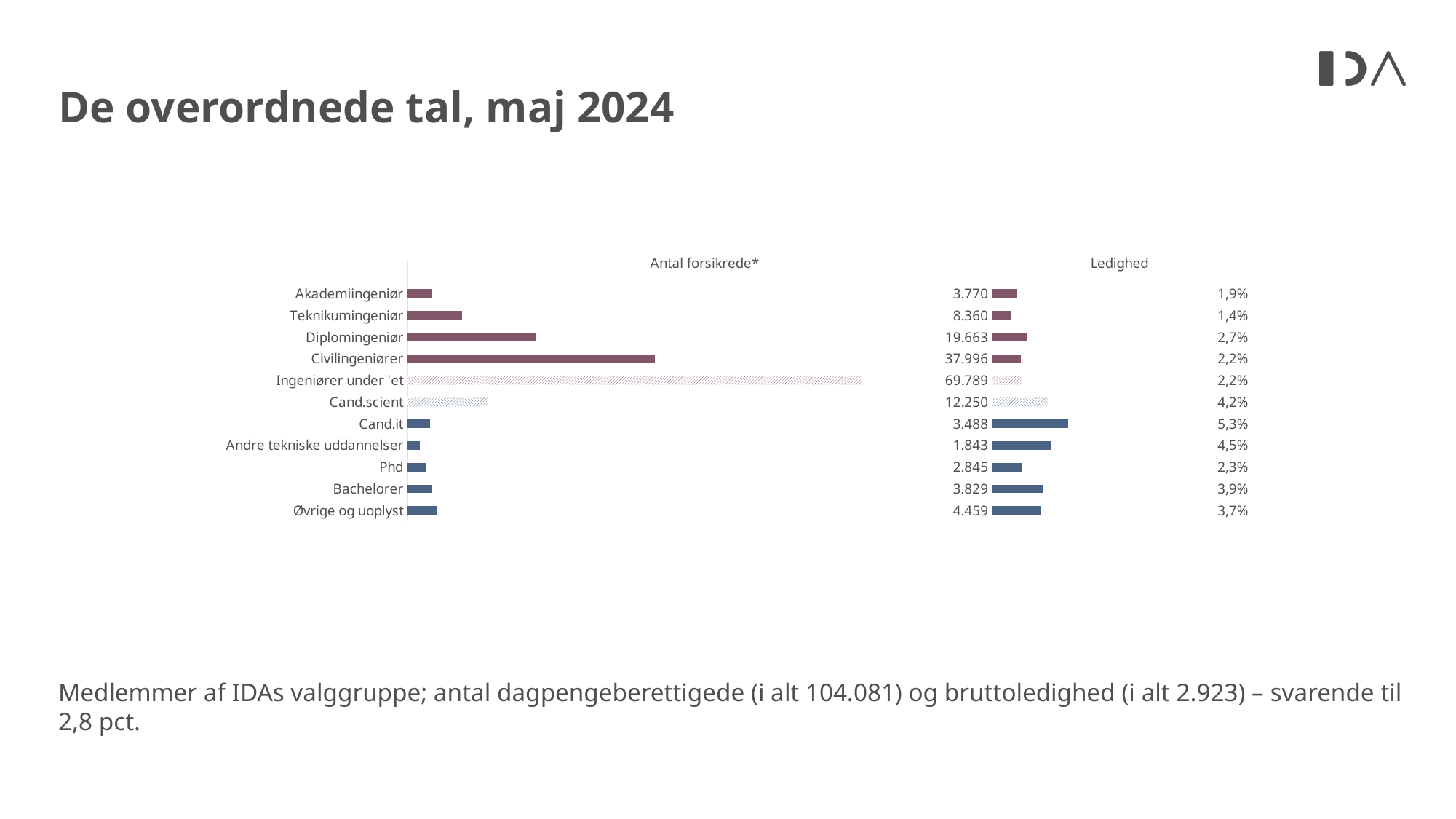
How many categories are shown in the 'Ledighed' chart? 11 In the 'Antal forsikrede*' chart, what is the value for Civilingeniører? 37.996 In the 'Ledighed' chart, what is the value for Cand.scient? 4,2% In the 'Ledighed' chart, which category has the lowest value? Teknikumingeniør What kind of chart is the 'Antal forsikrede*' chart? Bar chart In the 'Ledighed' chart, which category has the highest value? Cand.it In the 'Antal forsikrede*' chart, which category has the highest value? Ingeniører under 'et In the 'Antal forsikrede*' chart, which is larger: Cand.scient or Teknikumingeniør? Cand.scient In the 'Antal forsikrede*' chart, what is the difference between Civilingeniører and Diplomingeniør? 18.333 In the 'Ledighed' chart, what is the difference between Cand.it and Cand.scient? 1,1% In the 'Antal forsikrede*' chart, what is the value for Øvrige og uoplyst? 4.459 In the 'Antal forsikrede*' chart, which category has the lowest value? Andre tekniske uddannelser